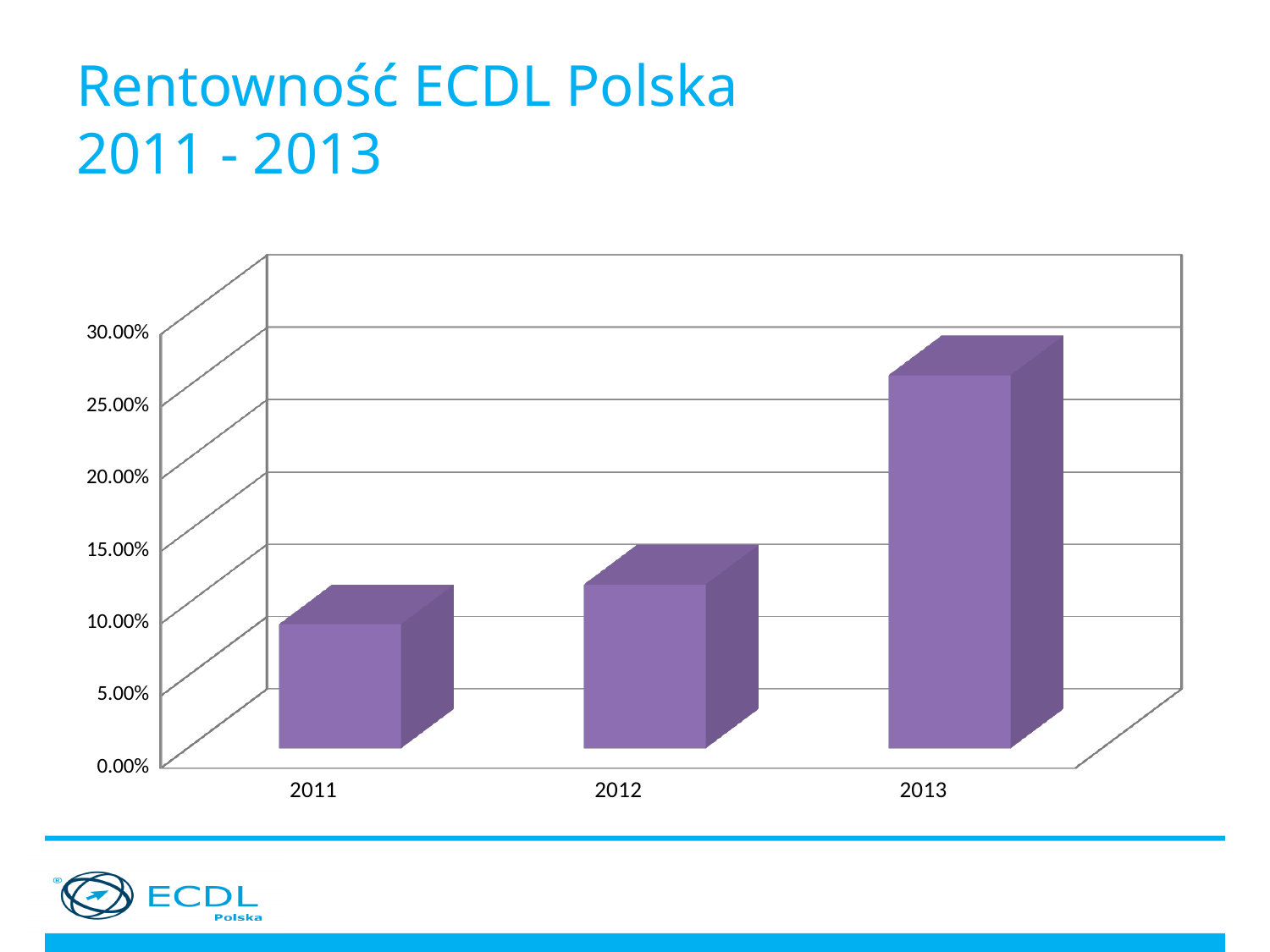
Which is larger, the value for 2012 or the value for 2011? 2012 Is the value for 2013 greater or less than 20.00%? greater Which year has the highest value in the chart? 2013 Is the value for 2011 greater or less than 15.00%? less Which is larger, the value for 2013 or the value for 2012? 2013 What kind of chart is shown on the slide? bar chart What is the title of the slide containing the chart? Rentowność ECDL Polska 2011 - 2013 How many years are shown on the x axis of the chart? 3 Is the value for 2012 greater or less than 20.00%? less Which year has the lowest value in the chart? 2011 Do the values rise or fall from 2011 to 2013? rise